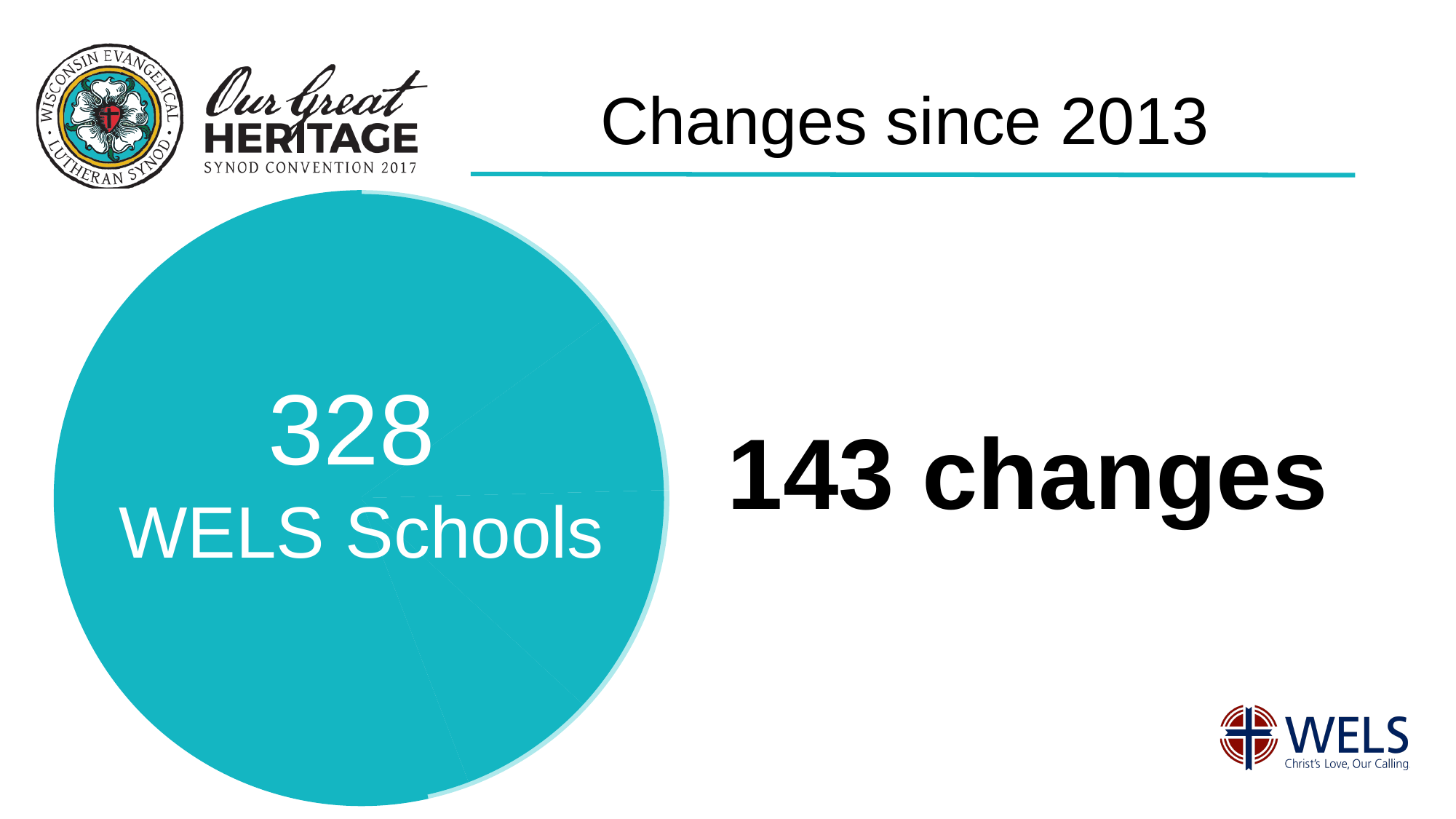
What label accompanies the number printed on the pie chart? WELS Schools What is the title of the slide containing the pie chart? Changes since 2013 What kind of chart is shown on the slide? pie chart What number is printed in the centre of the pie chart? 328 What colour is the pie chart? teal